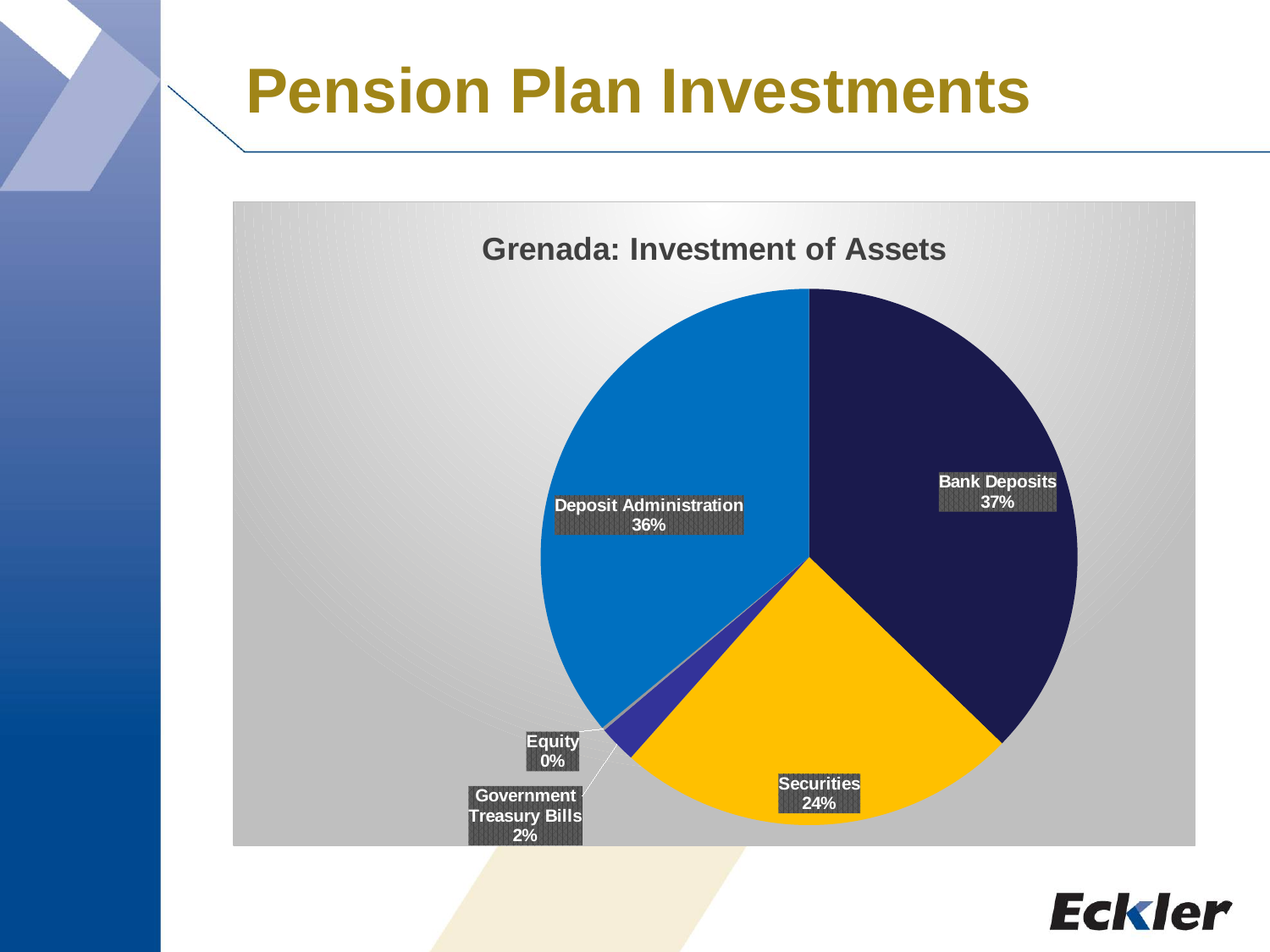
What share of assets is invested in Bank Deposits? 37% What share of assets is invested in Securities? 24% What type of chart is shown on the slide? pie chart What share of assets is invested in Government Treasury Bills? 2% Which category has the smallest share of the pie? Equity Which category has the largest share of the pie? Bank Deposits How many categories are shown in the pie chart? 5 Which is larger, the share for Securities or the share for Government Treasury Bills? Securities What is the title of the chart? Grenada: Investment of Assets What is the difference between the Bank Deposits share and the Securities share? 13%